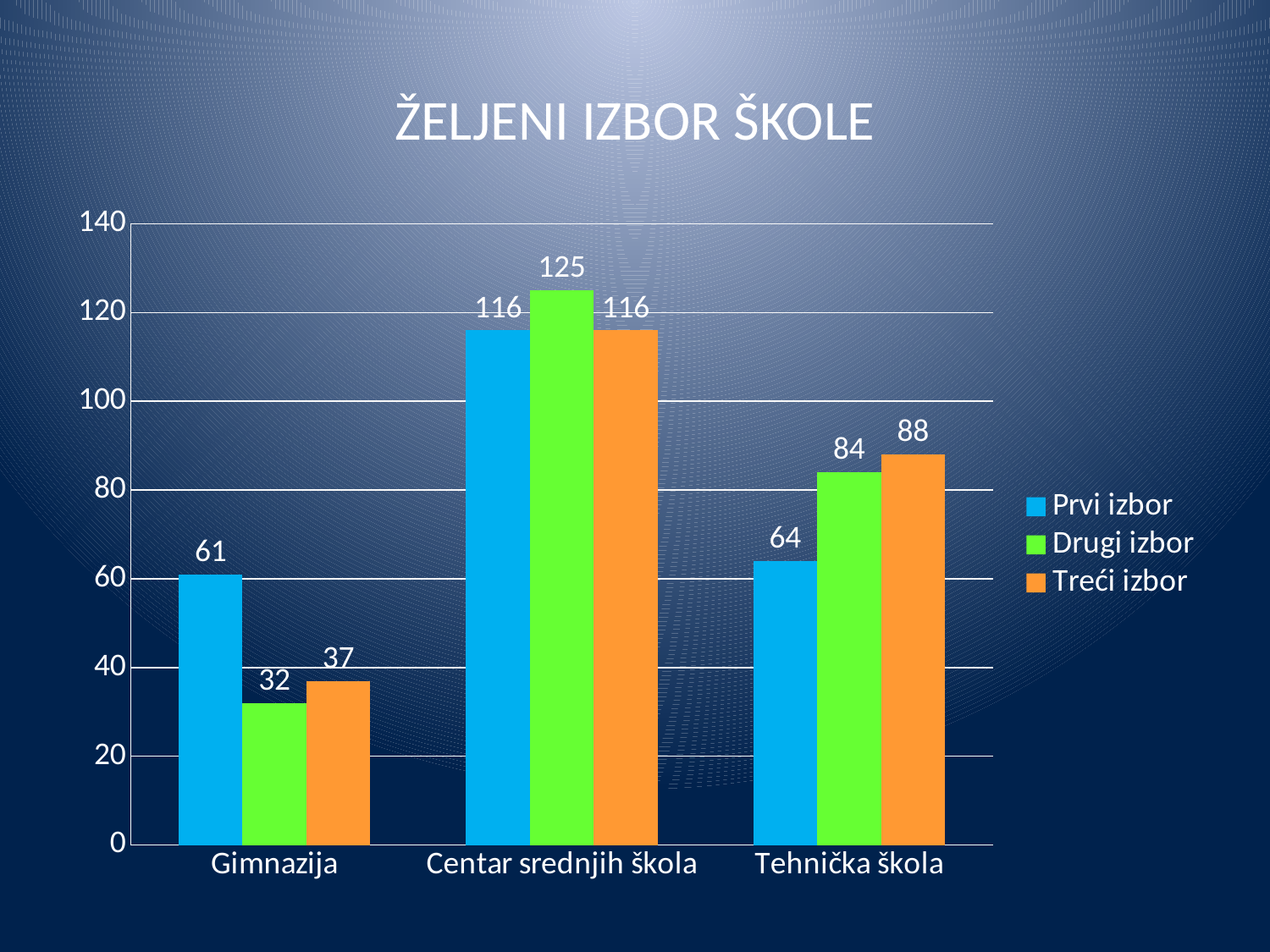
Which category has the lowest Drugi izbor value? Gimnazija Which is larger for Tehnička škola: Prvi izbor or Drugi izbor? Drugi izbor What kind of chart is shown on the slide? bar chart What is the value of Drugi izbor for Centar srednjih škola? 125 How many categories are shown on the x axis? 3 Which category has the highest Prvi izbor value? Centar srednjih škola What is the value of Prvi izbor for Gimnazija? 61 What is the title of the chart? ŽELJENI IZBOR ŠKOLE How many series does the legend list? 3 What is the difference between the Drugi izbor and Prvi izbor values for Centar srednjih škola? 9 What is the value of Treći izbor for Tehnička škola? 88 Is the Treći izbor value for Gimnazija greater or less than 40? less